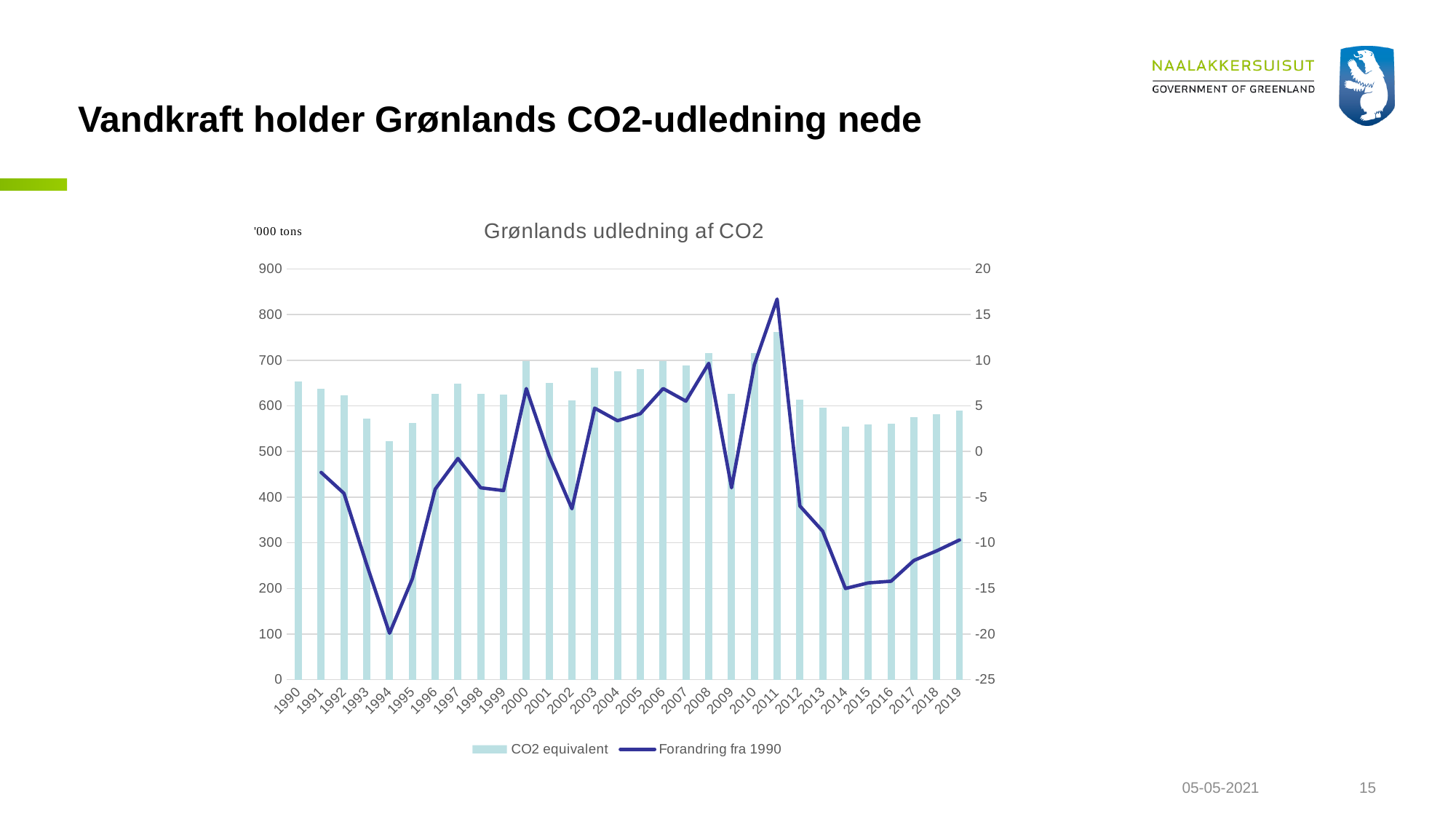
Which year has the highest CO2 equivalent bar? 2011 In which year does the 'Forandring fra 1990' line reach its lowest point? 1994 How many years are shown along the x axis of the chart? 30 Is the 'Forandring fra 1990' value for 2011 greater or less than 15? greater How many series does the chart legend list? 2 Do the CO2 equivalent bars rise or fall from 2011 to 2014? fall What kind of chart is shown on the slide? Combined bar and line chart What is the title of the chart? Grønlands udledning af CO2 Is the CO2 equivalent value for 1994 greater or less than 600? less Which year has the larger CO2 equivalent bar, 2000 or 2019? 2000 Is the CO2 equivalent value for 2011 greater or less than 700? greater Which year has the lowest CO2 equivalent bar? 1994